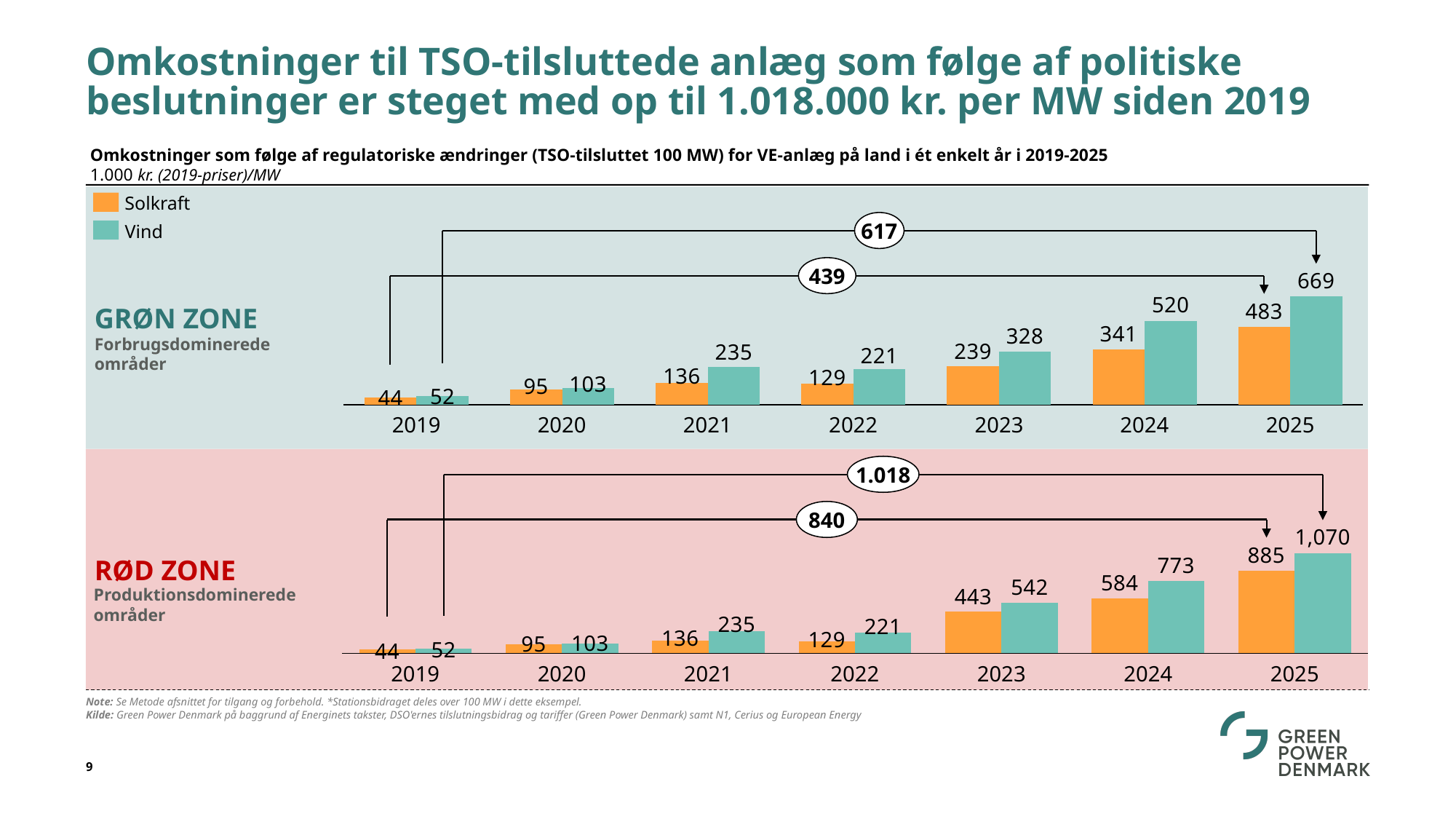
In the GRØN ZONE chart, what is the difference between the Vind and Solkraft values in 2024? 179 In the RØD ZONE chart, which is larger in 2023: Solkraft or Vind? Vind Which colour represents Solkraft in the legend? Orange In the RØD ZONE chart, do the Vind values generally rise or fall from 2019 to 2025? Rise How many series does the legend list? 2 In the RØD ZONE chart, which year has the highest Vind value? 2025 In the RØD ZONE chart, what is the value for Solkraft in 2024? 584 What kind of chart is the RØD ZONE chart? Bar chart How many years are shown on the x axis of the GRØN ZONE chart? 7 In the GRØN ZONE chart, which year has the lowest Solkraft value? 2019 In the GRØN ZONE chart, what is the difference between the Solkraft value in 2022 and in 2021? 7 In the GRØN ZONE chart, what is the value for Vind in 2025? 669